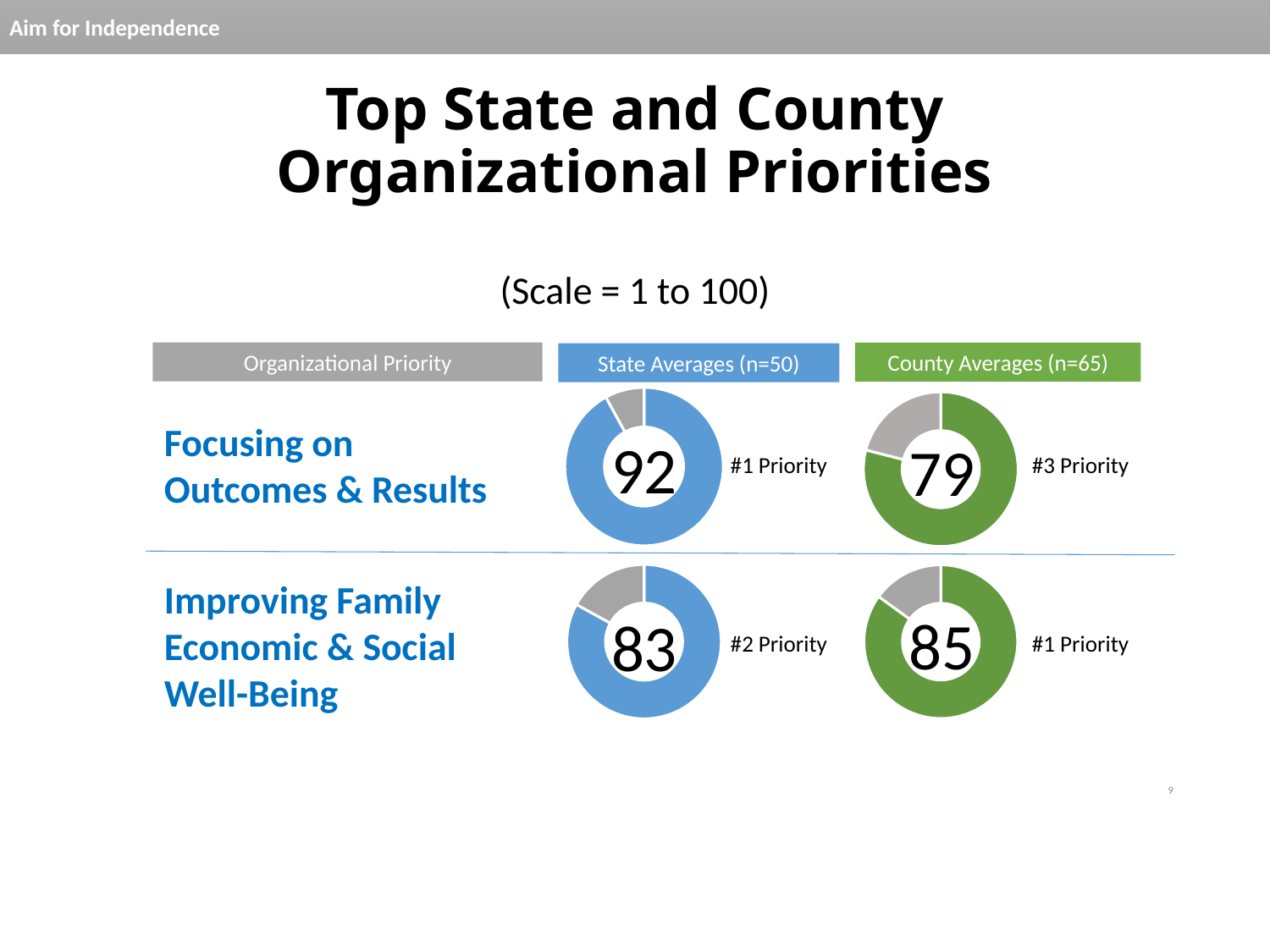
What is the State Average for Focusing on Outcomes & Results? 92 What is the difference between the State Average and the County Average for Focusing on Outcomes & Results? 13 How many donut charts are shown on the slide? 4 What priority rank does Focusing on Outcomes & Results hold in the County Averages? #3 Priority Which of the four donut charts shows the highest value? State Average for Focusing on Outcomes & Results (92) What is the County Average for Focusing on Outcomes & Results? 79 What is the State Average for Improving Family Economic & Social Well-Being? 83 Which of the four donut charts shows the lowest value? County Average for Focusing on Outcomes & Results (79) For Improving Family Economic & Social Well-Being, which is larger: the State Average or the County Average? County Average What is the difference between the County Average and the State Average for Improving Family Economic & Social Well-Being? 2 What kind of chart is used to display each average on the slide? Donut chart What is the County Average for Improving Family Economic & Social Well-Being? 85